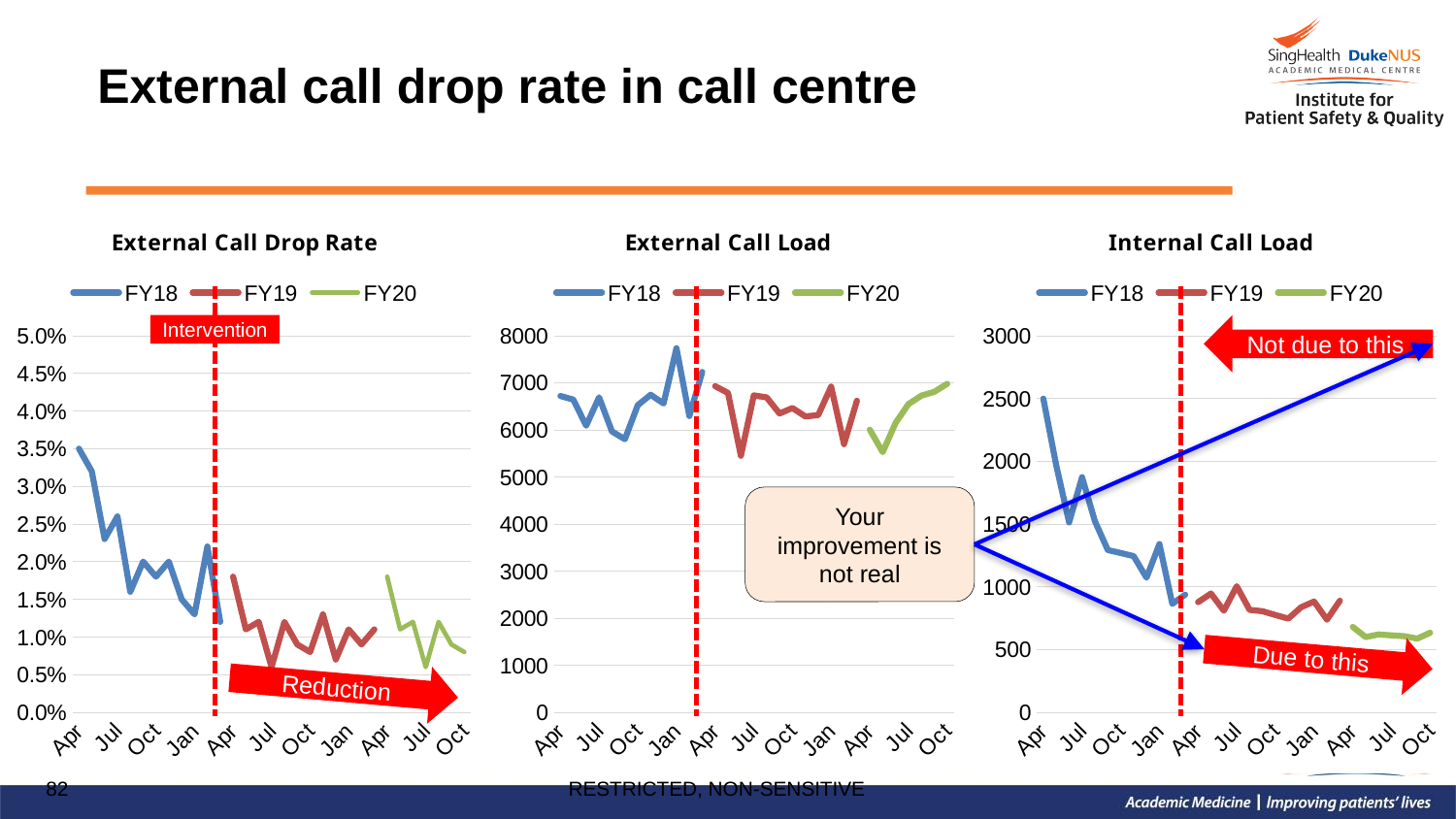
In the External Call Drop Rate chart, is the FY18 value for Apr greater or less than 3.0%? greater What colour is the FY19 line in the External Call Drop Rate chart? red In the External Call Drop Rate chart, does the FY18 line generally rise or fall from Apr to Apr? fall In the Internal Call Load chart, is the FY20 value for Oct greater or less than 1000? less In the Internal Call Load chart, does the FY18 line generally rise or fall over time? fall In the Internal Call Load chart, is the FY18 value for Apr greater or less than 2000? greater Which series are listed in the legend of the Internal Call Load chart? FY18, FY19, FY20 What kind of chart is the External Call Drop Rate chart? line chart How many series does the legend of the External Call Load chart list? 3